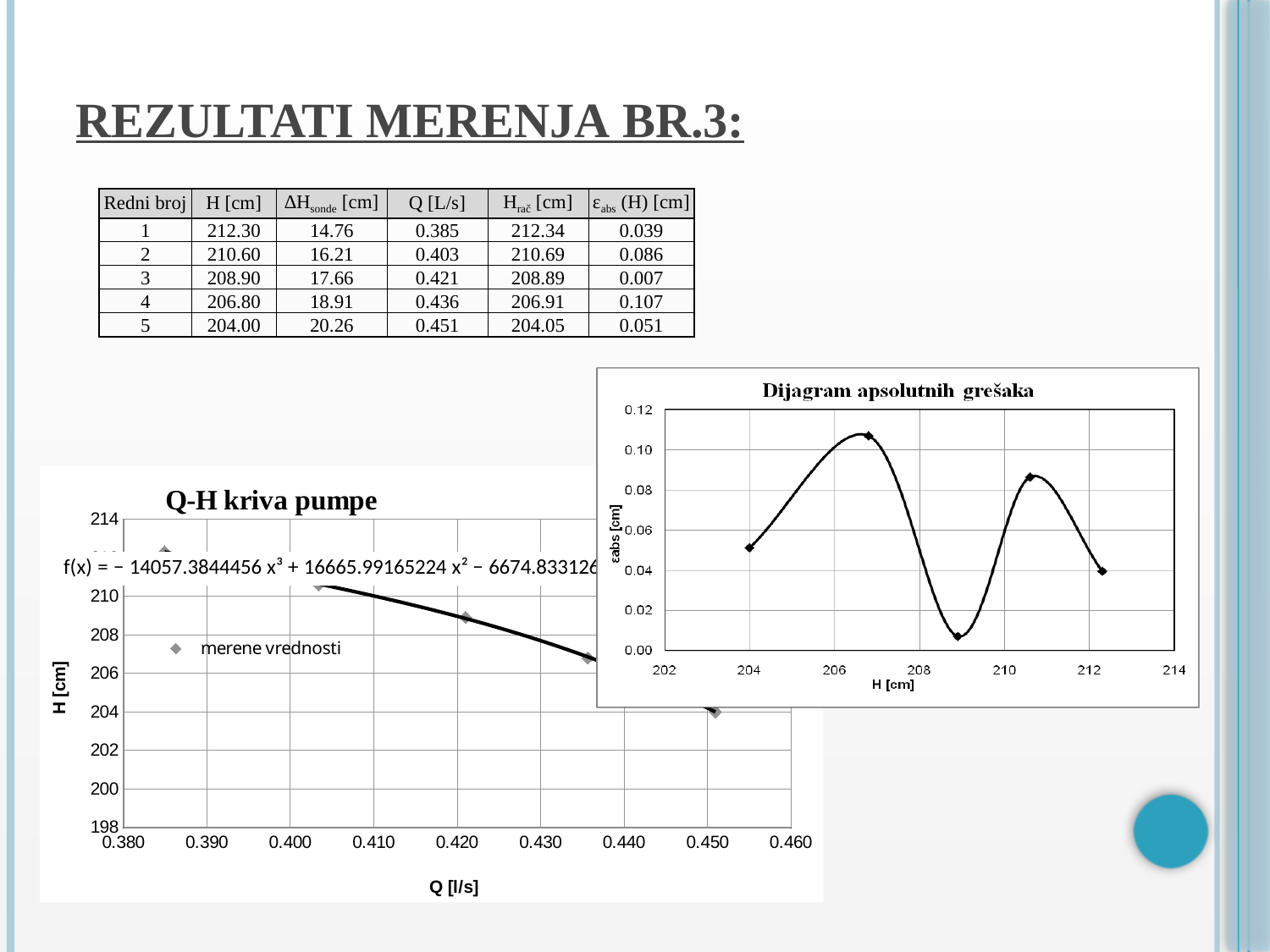
What kind of chart is 'Dijagram apsolutnih grešaka'? line chart In the 'Dijagram apsolutnih grešaka' chart, is the error value of the point near H = 209 greater or less than 0.02? less In the 'Dijagram apsolutnih grešaka' chart, which of the two points, the one near H = 207 or the one near H = 209, has the larger error value? the one near H = 207 In the 'Q-H kriva pumpe' chart, how many measured data points are plotted? 5 In the 'Q-H kriva pumpe' chart, is the H value of the point near Q = 0.385 greater or less than 210? greater In the 'Q-H kriva pumpe' chart, how many series does the legend list? 1 In the 'Q-H kriva pumpe' chart, is the H value at Q = 0.450 greater or less than 206? less In the 'Dijagram apsolutnih grešaka' chart, how many data points are plotted? 5 In the 'Q-H kriva pumpe' chart, do the H values rise or fall as Q increases along the x axis? fall What is the title of the chart in the lower left of the slide? Q-H kriva pumpe What is the title of the chart on the right side of the slide? Dijagram apsolutnih grešaka